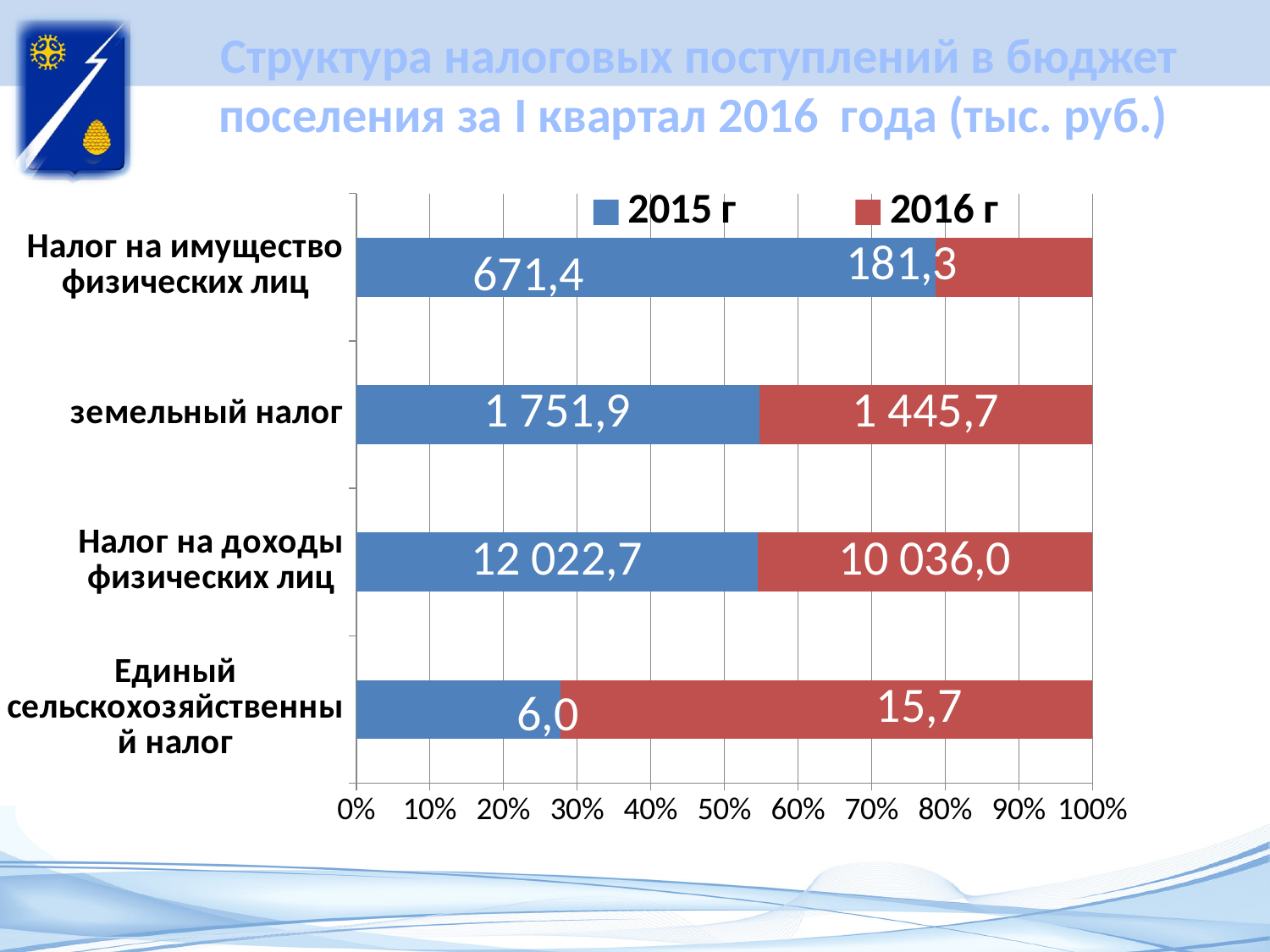
How many tax categories are shown on the chart? 4 Which category has the lowest 2016 г value? Единый сельскохозяйственный налог What kind of chart is shown on the slide? Stacked bar chart What is the total of the 2015 г and 2016 г values for Налог на доходы физических лиц? 22 058,7 What is the difference between the 2015 г and 2016 г values for земельный налог? 306,2 What is the 2016 г value for Налог на имущество физических лиц? 181,3 What is the 2016 г value for Единый сельскохозяйственный налог? 15,7 How many series does the legend list? 2 Which is larger for Единый сельскохозяйственный налог, the 2015 г value or the 2016 г value? 2016 г Which category has the highest 2015 г value? Налог на доходы физических лиц What is the 2015 г value for земельный налог? 1 751,9 What is the 2015 г value for Налог на доходы физических лиц? 12 022,7